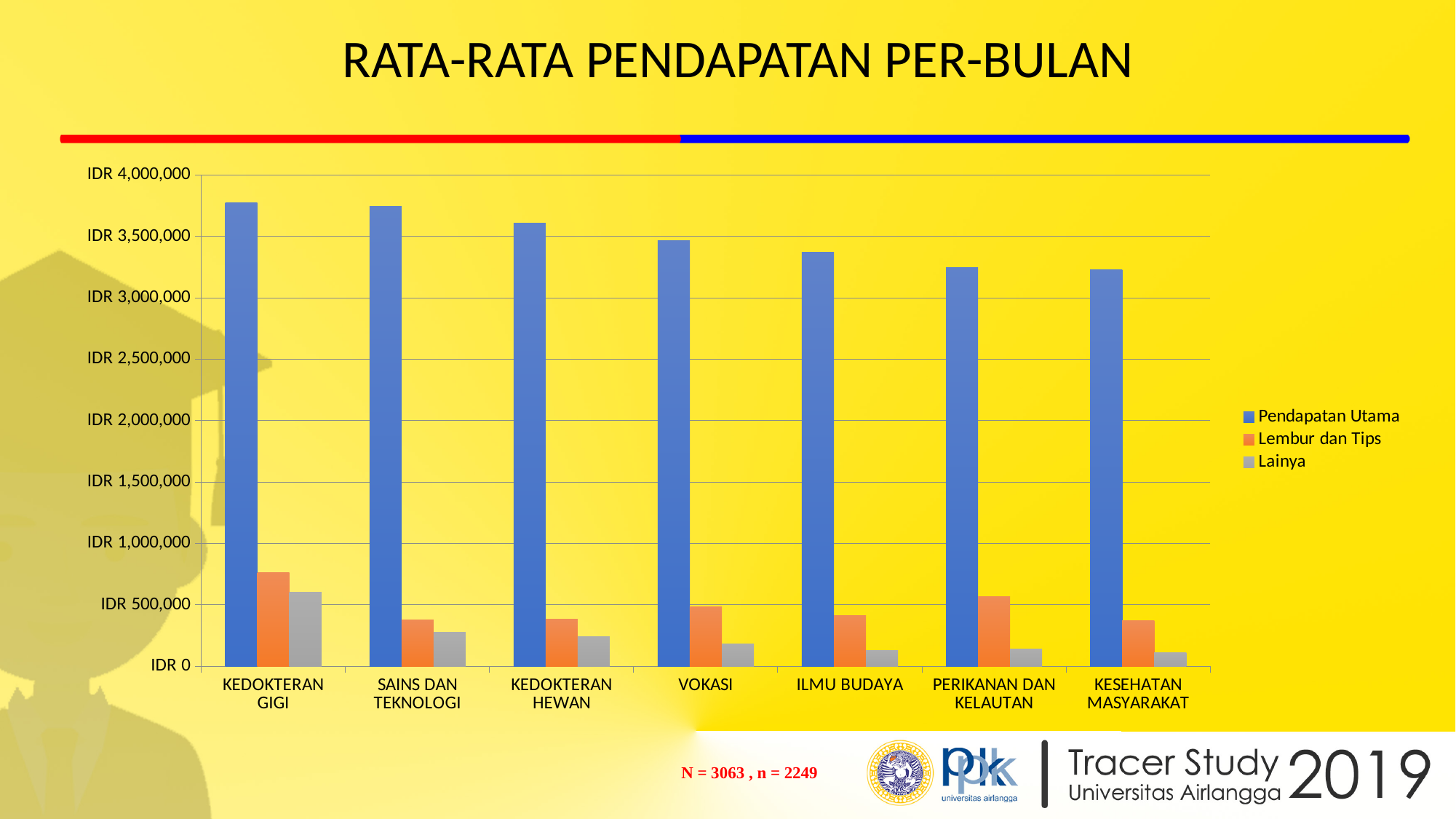
Is the Pendapatan Utama value for KEDOKTERAN GIGI greater or less than IDR 3,500,000? greater Is the Lainya value for VOKASI greater or less than IDR 500,000? less What kind of chart is shown on the slide? bar chart How many faculty categories are shown on the x axis? 7 What is the title of the chart? RATA-RATA PENDAPATAN PER-BULAN Which category has the highest Lembur dan Tips value? KEDOKTERAN GIGI How many series does the legend list? 3 Which category has the highest Lainya value? KEDOKTERAN GIGI Is the Pendapatan Utama value for ILMU BUDAYA greater or less than IDR 3,500,000? less Which has the larger Pendapatan Utama value, KEDOKTERAN HEWAN or ILMU BUDAYA? KEDOKTERAN HEWAN Do the Pendapatan Utama values rise or fall from left to right across the categories? fall